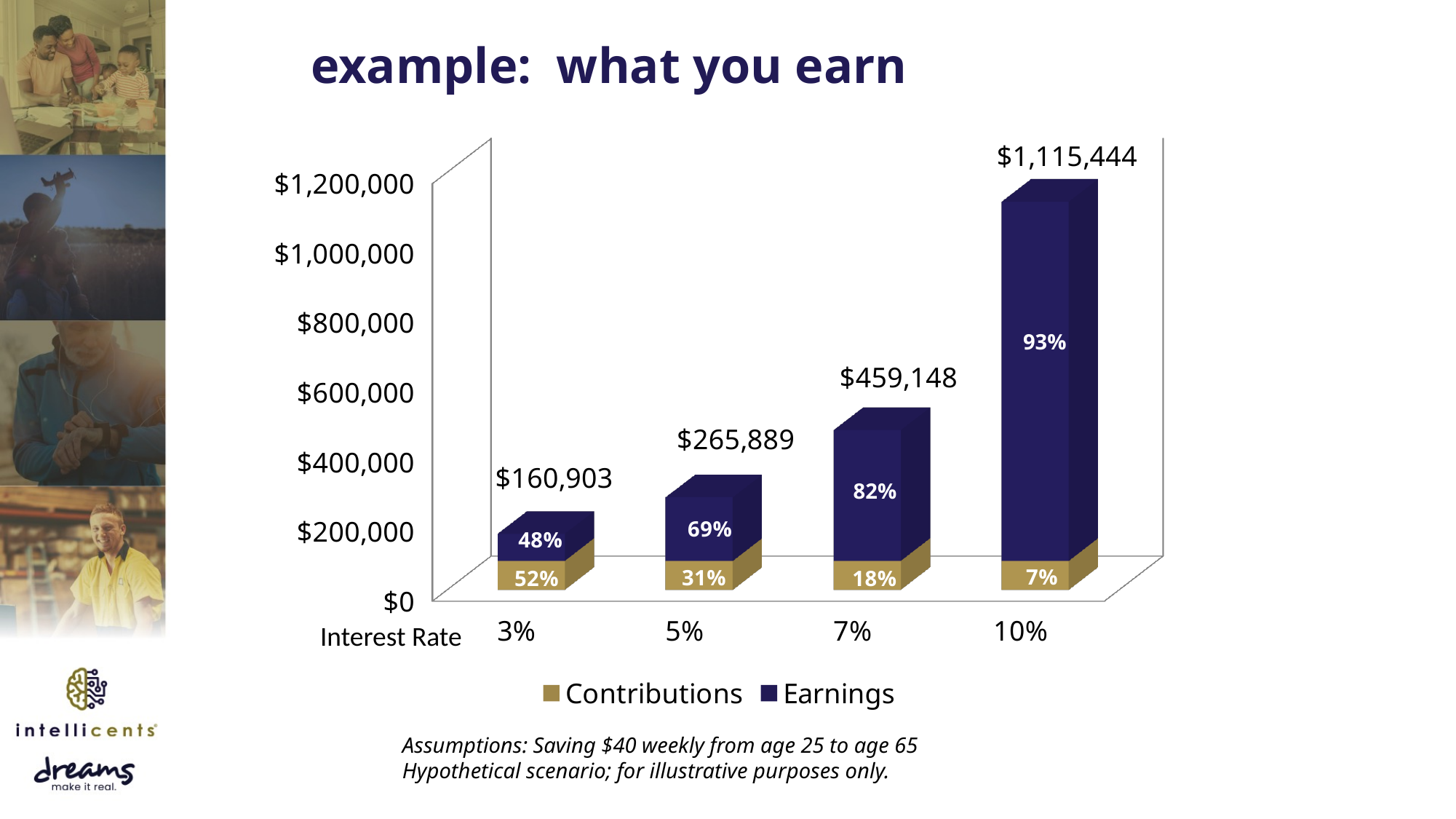
Which is larger, the total for the 5% interest rate or the total for the 7% interest rate? 7% Which interest rate has the highest total value? 10% How many interest rate categories are shown on the x axis? 4 What is the total value shown above the bar for the 10% interest rate? $1,115,444 What is the difference between the total for the 10% interest rate and the total for the 7% interest rate? $656,296 What percentage of the 5% interest rate bar is Contributions? 31% What percentage of the 7% interest rate bar is Earnings? 82% What is the total value shown above the bar for the 3% interest rate? $160,903 What kind of chart is shown on the slide? Stacked bar chart Which interest rate has the lowest total value? 3% How many series does the legend list? 2 Do the total values rise or fall as the interest rate increases along the x axis? Rise